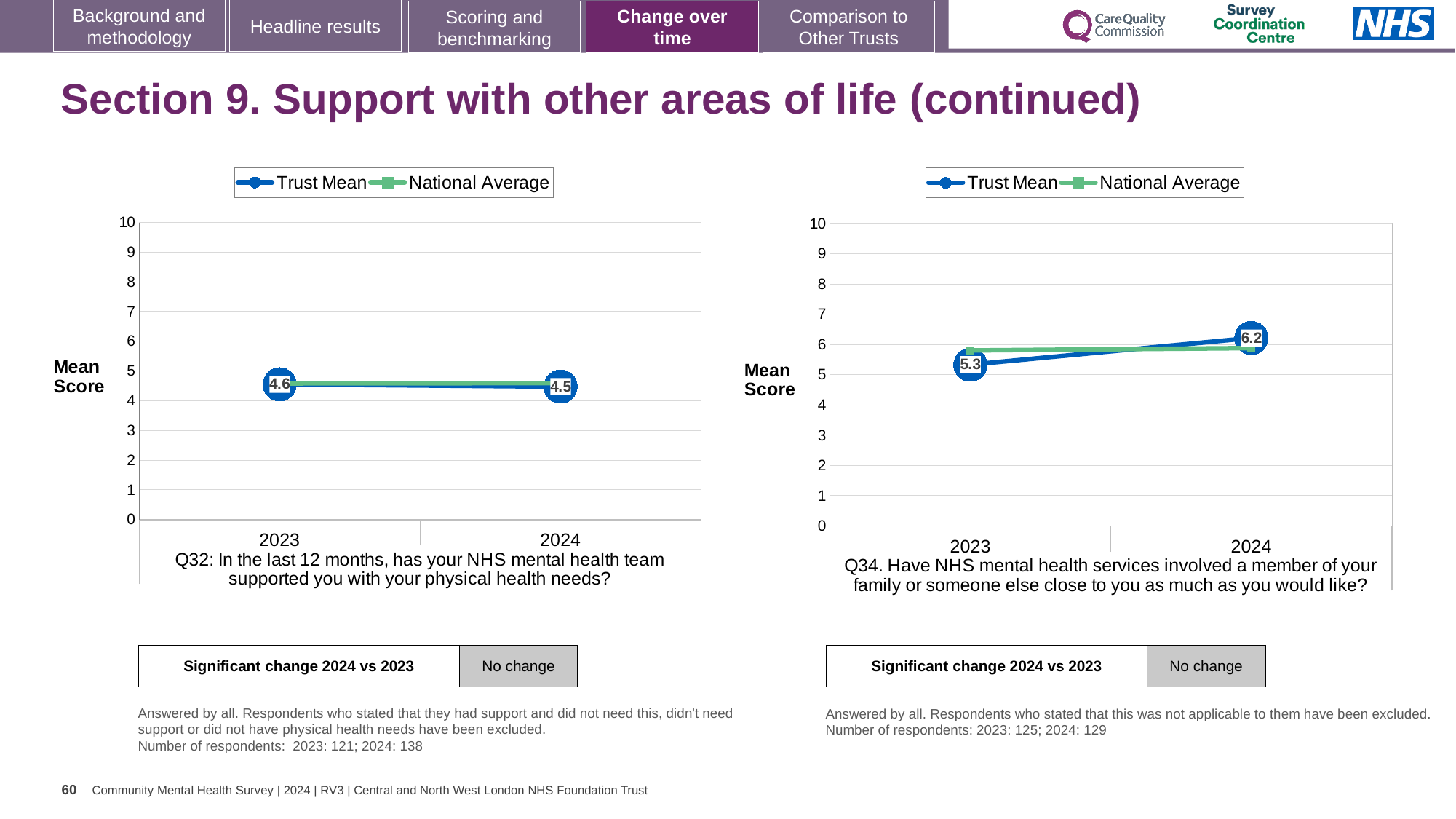
In the right chart (Q34), what is the Trust Mean score for 2023? 5.3 In the right chart (Q34), is the Trust Mean for 2024 greater or less than 6? greater In the left chart (Q32), what is the Trust Mean score for 2023? 4.6 In the left chart (Q32), what is the Trust Mean score for 2024? 4.5 How many years are plotted on the x axis of the right chart (Q34)? 2 What type of chart is the left chart (Q32)? line chart In the right chart (Q34), does the Trust Mean rise or fall from 2023 to 2024? rise How many series does the legend of the left chart (Q32) list? 2 In the right chart (Q34), is the National Average for 2023 greater or less than the Trust Mean for 2023? greater In the right chart (Q34), by how much did the Trust Mean change from 2023 to 2024? 0.9 In the right chart (Q34), what is the Trust Mean score for 2024? 6.2 In the left chart (Q32), what is the difference between the Trust Mean in 2023 and 2024? 0.1